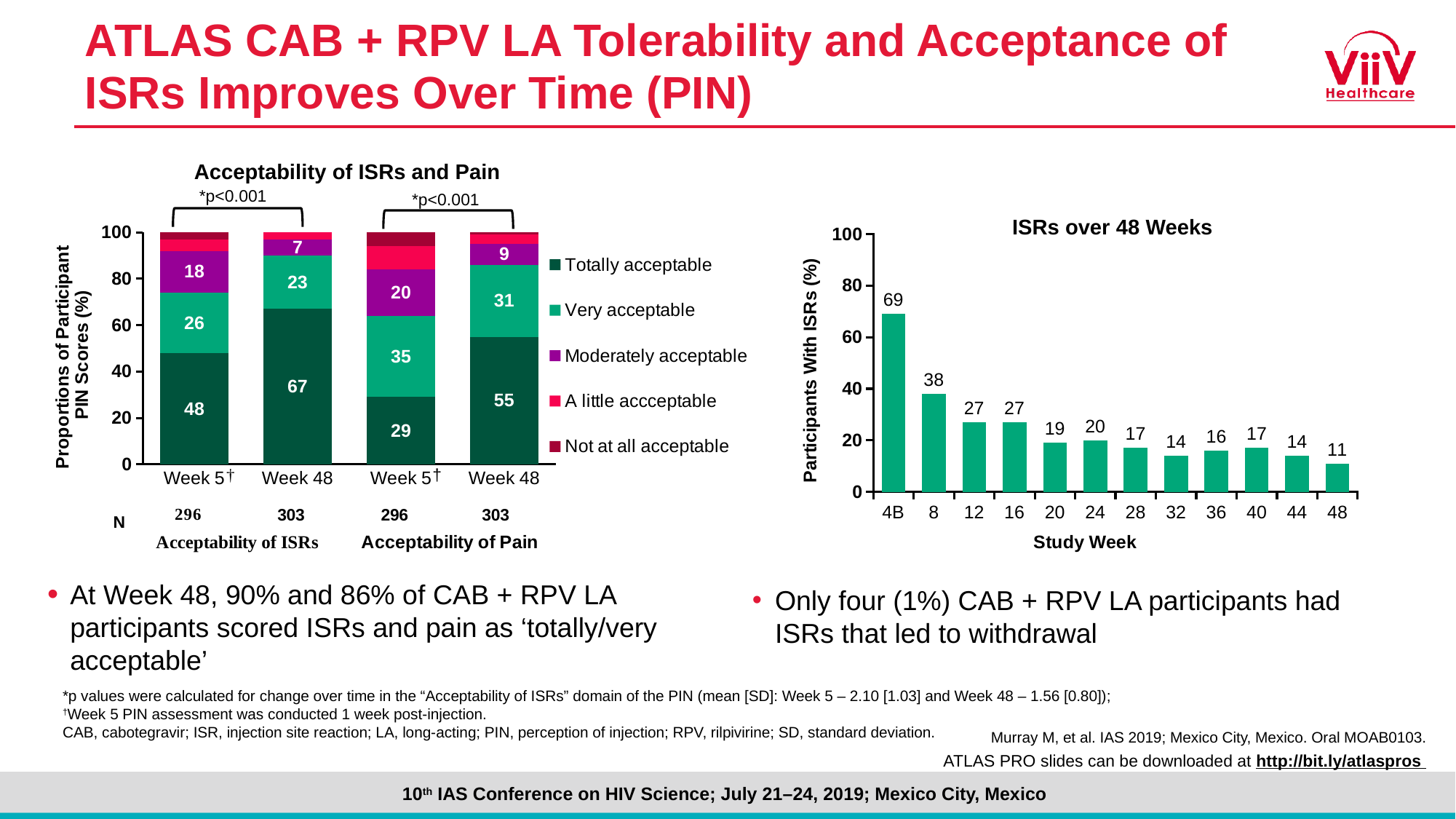
In the 'ISRs over 48 Weeks' chart, what is the difference between the values for week 4B and week 8? 31 In the 'ISRs over 48 Weeks' chart, what is the value for study week 4B? 69 In the 'Acceptability of ISRs and Pain' chart, how many categories does the legend list? 5 In the 'ISRs over 48 Weeks' chart, how many study weeks are plotted on the x axis? 12 In the 'ISRs over 48 Weeks' chart, do the values generally rise or fall from week 4B to week 48? fall What kind of chart is 'ISRs over 48 Weeks'? bar chart In the 'ISRs over 48 Weeks' chart, what is the value for study week 48? 11 In the 'Acceptability of ISRs and Pain' chart, what percentage of participants rated ISRs as 'Totally acceptable' at Week 48? 67 In the 'ISRs over 48 Weeks' chart, which study week has the lowest percentage of participants with ISRs? 48 In the 'ISRs over 48 Weeks' chart, which study week has the highest percentage of participants with ISRs? 4B In the 'Acceptability of ISRs and Pain' chart, what percentage of participants rated pain as 'Very acceptable' at Week 5? 35 In the 'Acceptability of ISRs and Pain' chart, what is the difference in the 'Totally acceptable' share for ISRs between Week 48 and Week 5? 19